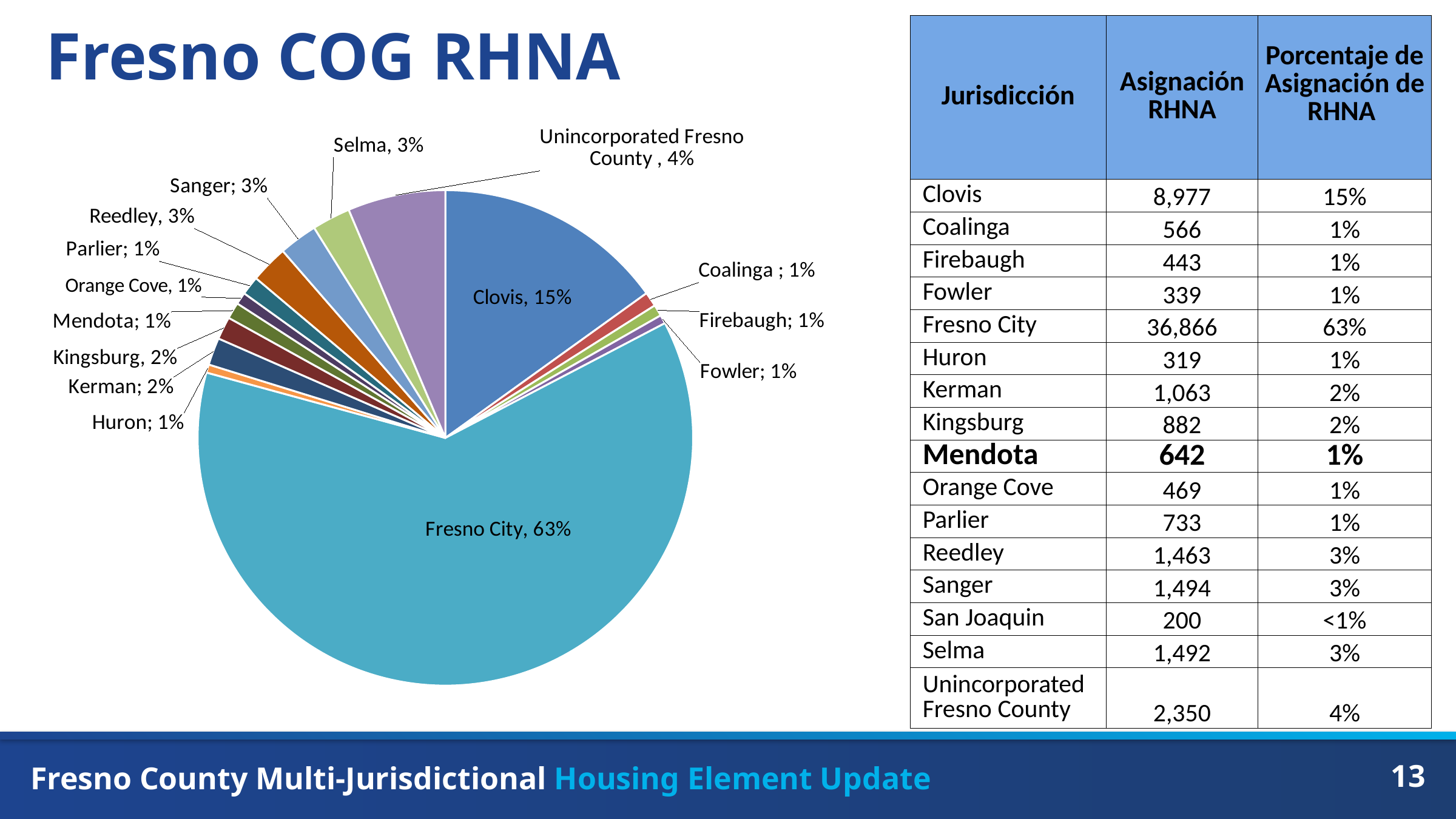
What percentage is shown for Unincorporated Fresno County in the pie chart? 4% Which slice is larger in the pie chart, Sanger or Parlier? Sanger Which jurisdiction has the largest slice of the pie chart? Fresno City What percentage is shown for Clovis in the pie chart? 15% What share of the pie does Fresno City hold? 63% What is the difference in percentage points between the Unincorporated Fresno County slice and the Kingsburg slice? 2 What percentage is shown for Mendota in the pie chart? 1% What type of chart is shown on the slide? pie chart Which slice is larger in the pie chart, Clovis or Unincorporated Fresno County? Clovis What is the difference in percentage points between the Fresno City slice and the Clovis slice? 48 What percentage is shown for Kerman in the pie chart? 2% What percentage is shown for Selma in the pie chart? 3%